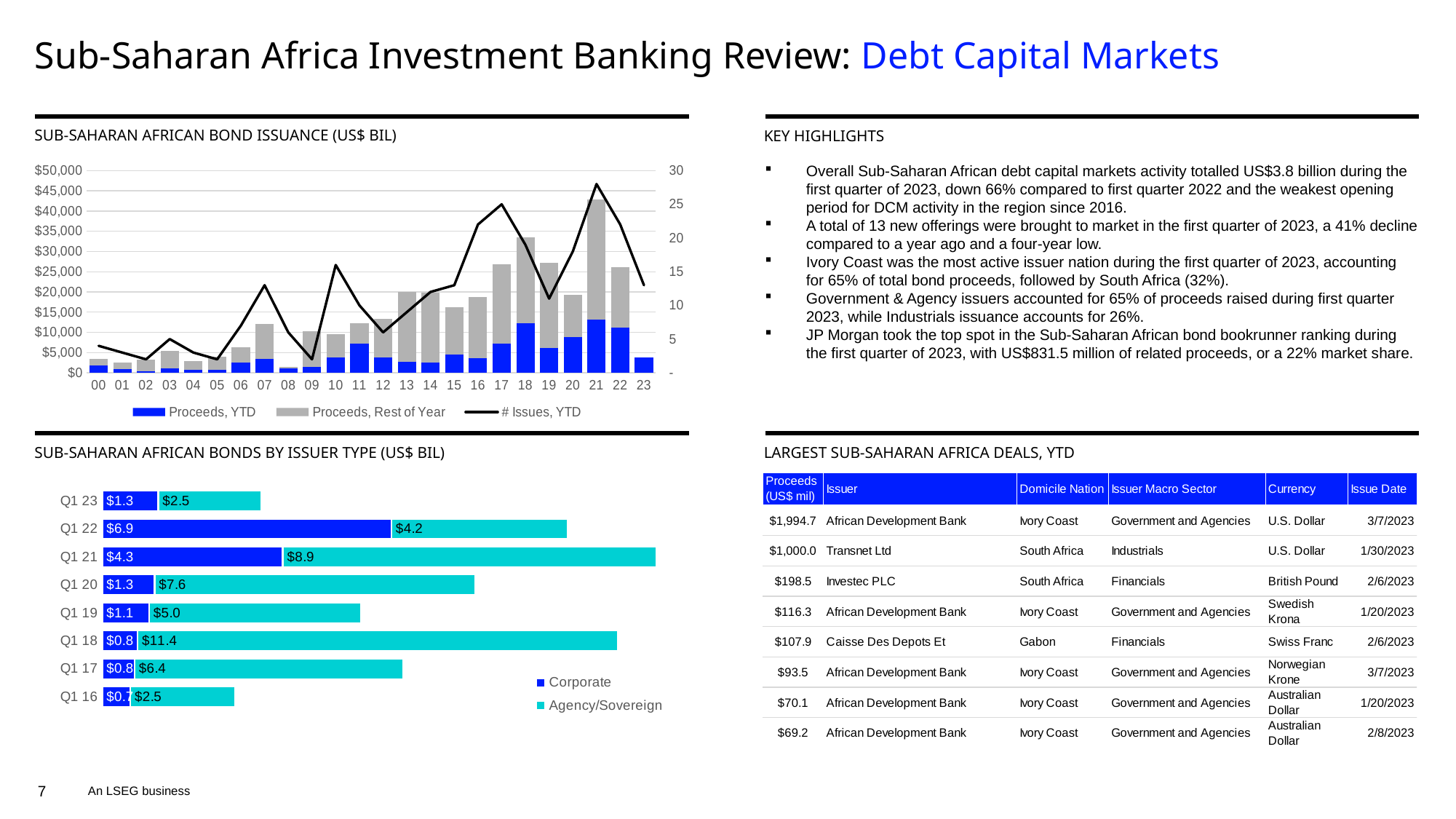
In the 'Sub-Saharan African Bonds by Issuer Type' chart, what is the Agency/Sovereign value for Q1 18? $11.4 In the 'Sub-Saharan African Bonds by Issuer Type' chart, what is the total of the Q1 22 bar? $11.1 How many series does the legend of the 'Sub-Saharan African Bond Issuance' chart list? 3 In the 'Sub-Saharan African Bond Issuance' chart, is the total bar for 23 greater or less than $5,000? less In the 'Sub-Saharan African Bond Issuance' chart, which year has the tallest bar? 21 What kind of chart is the 'Sub-Saharan African Bonds by Issuer Type' chart? stacked bar chart In the 'Sub-Saharan African Bonds by Issuer Type' chart, is the Corporate value for Q1 21 larger or smaller than the Corporate value for Q1 22? smaller How many periods are shown in the 'Sub-Saharan African Bonds by Issuer Type' chart? 8 In the 'Sub-Saharan African Bonds by Issuer Type' chart, which period has the highest Agency/Sovereign value? Q1 18 In the 'Sub-Saharan African Bonds by Issuer Type' chart, which period has the lowest Corporate value? Q1 16 In the 'Sub-Saharan African Bonds by Issuer Type' chart, what is the difference between the Agency/Sovereign values for Q1 21 and Q1 23? $6.4 In the 'Sub-Saharan African Bonds by Issuer Type' chart, what is the Corporate value for Q1 22? $6.9